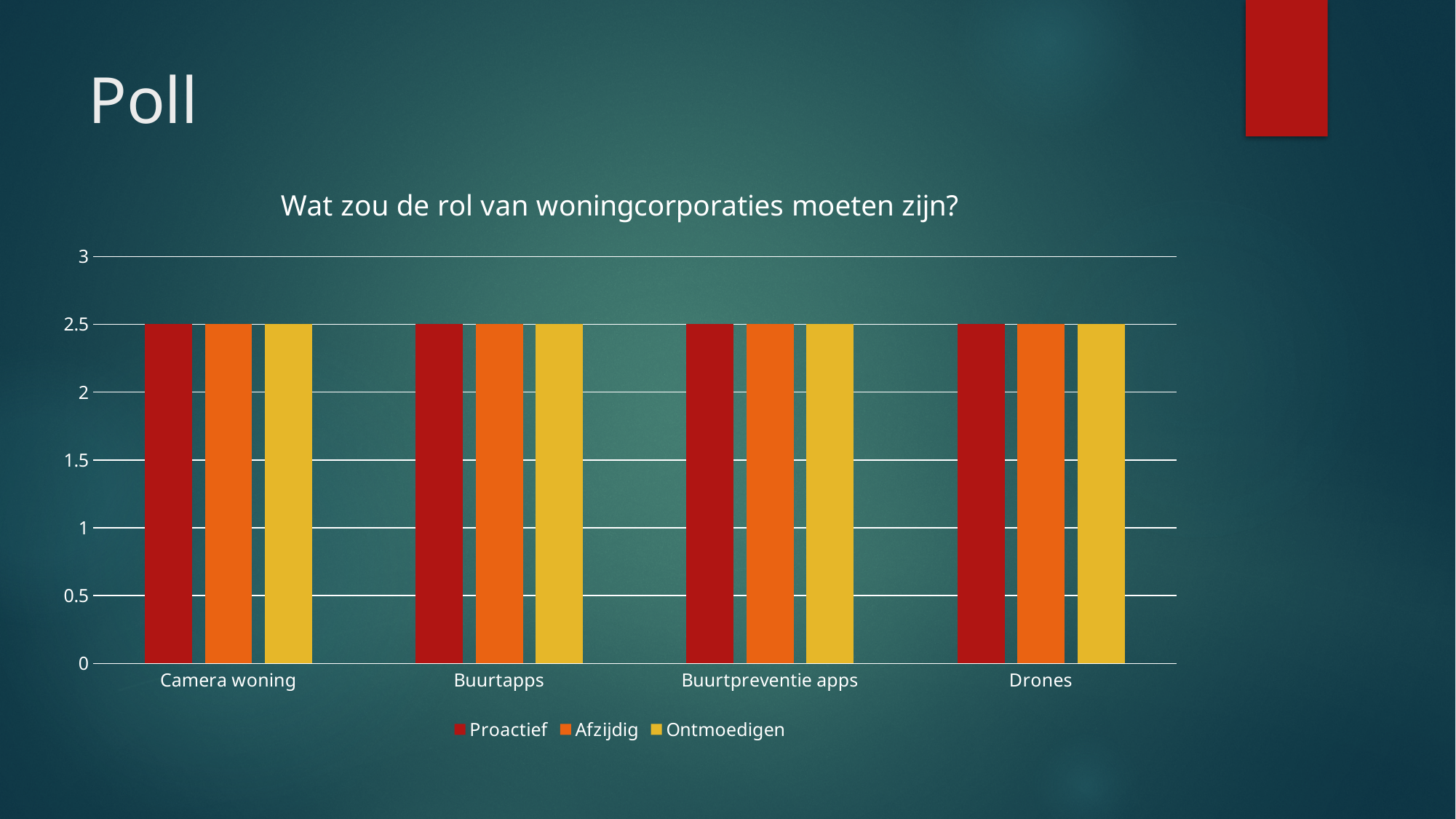
What is the title of the chart? Wat zou de rol van woningcorporaties moeten zijn? What is the value for Afzijdig in the Buurtapps category? 2.5 How many categories are shown on the x axis? 4 What kind of chart is shown on the slide? bar chart How many series does the legend list? 3 Which series is shown in yellow in the legend? Ontmoedigen Do the Proactief values rise, fall, or stay the same across the categories from left to right? stay the same Is the value for Afzijdig in the Drones category greater or less than 3? less What is the value for Ontmoedigen in the Drones category? 2.5 What is the difference between the Proactief value for Camera woning and the Proactief value for Drones? 0 Is the value for Proactief in the Buurtpreventie apps category greater or less than 2? greater What is the value for Proactief in the Camera woning category? 2.5